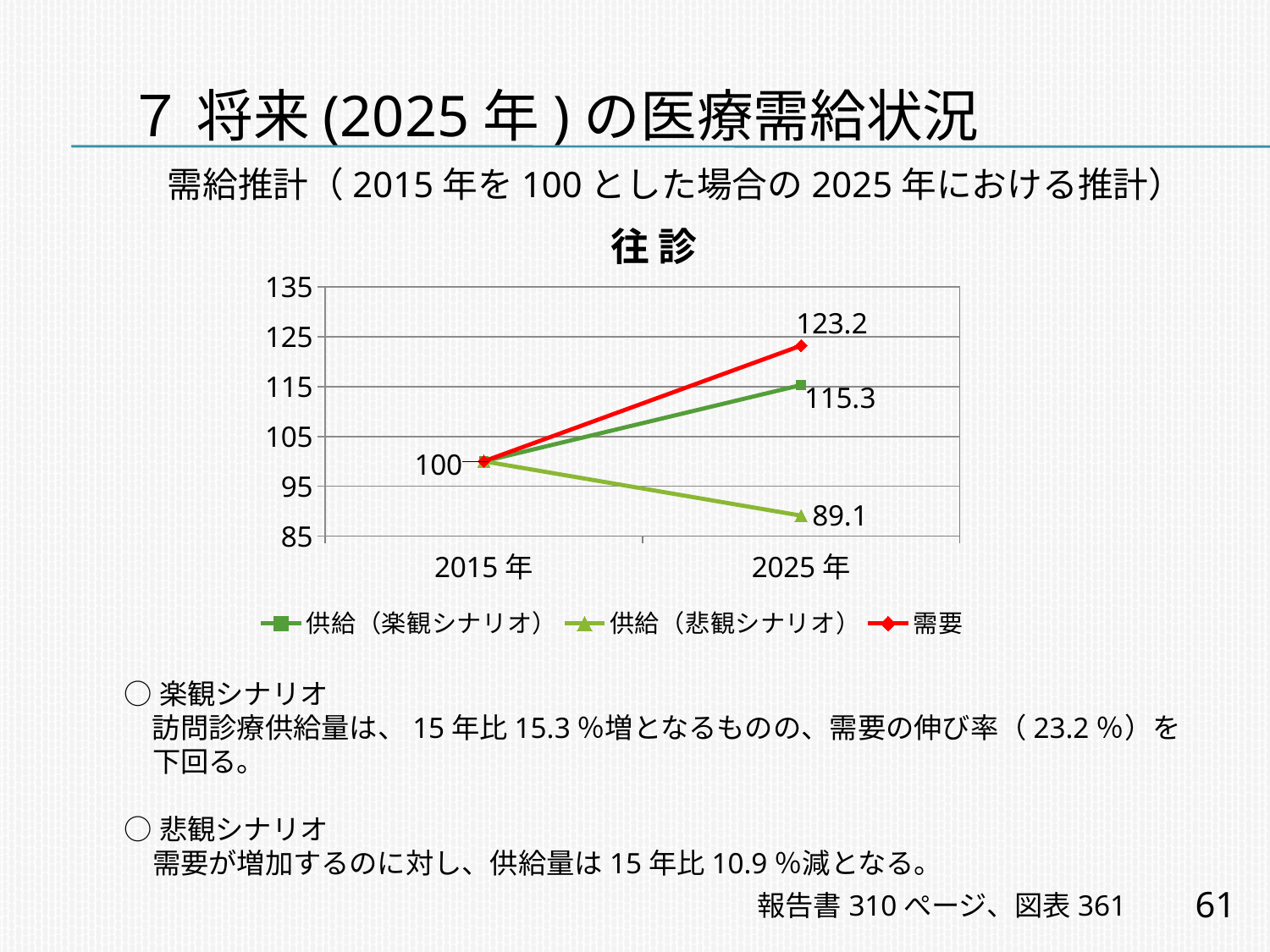
What is the value of 需要 in 2025年? 123.2 What is the value of 供給（悲観シナリオ） in 2025年? 89.1 What is the title of the chart? 往診 What type of chart is shown on the slide? line chart Which is larger in 2025年, 供給（楽観シナリオ） or 供給（悲観シナリオ）? 供給（楽観シナリオ） What is the value of all series in 2015年? 100 What is the difference between 需要 and 供給（楽観シナリオ） in 2025年? 7.9 What is the value of 供給（楽観シナリオ） in 2025年? 115.3 Which series has the highest value in 2025年? 需要 Does the 供給（悲観シナリオ） series rise or fall from 2015年 to 2025年? fall Which series has the lowest value in 2025年? 供給（悲観シナリオ） How many series does the legend list? 3